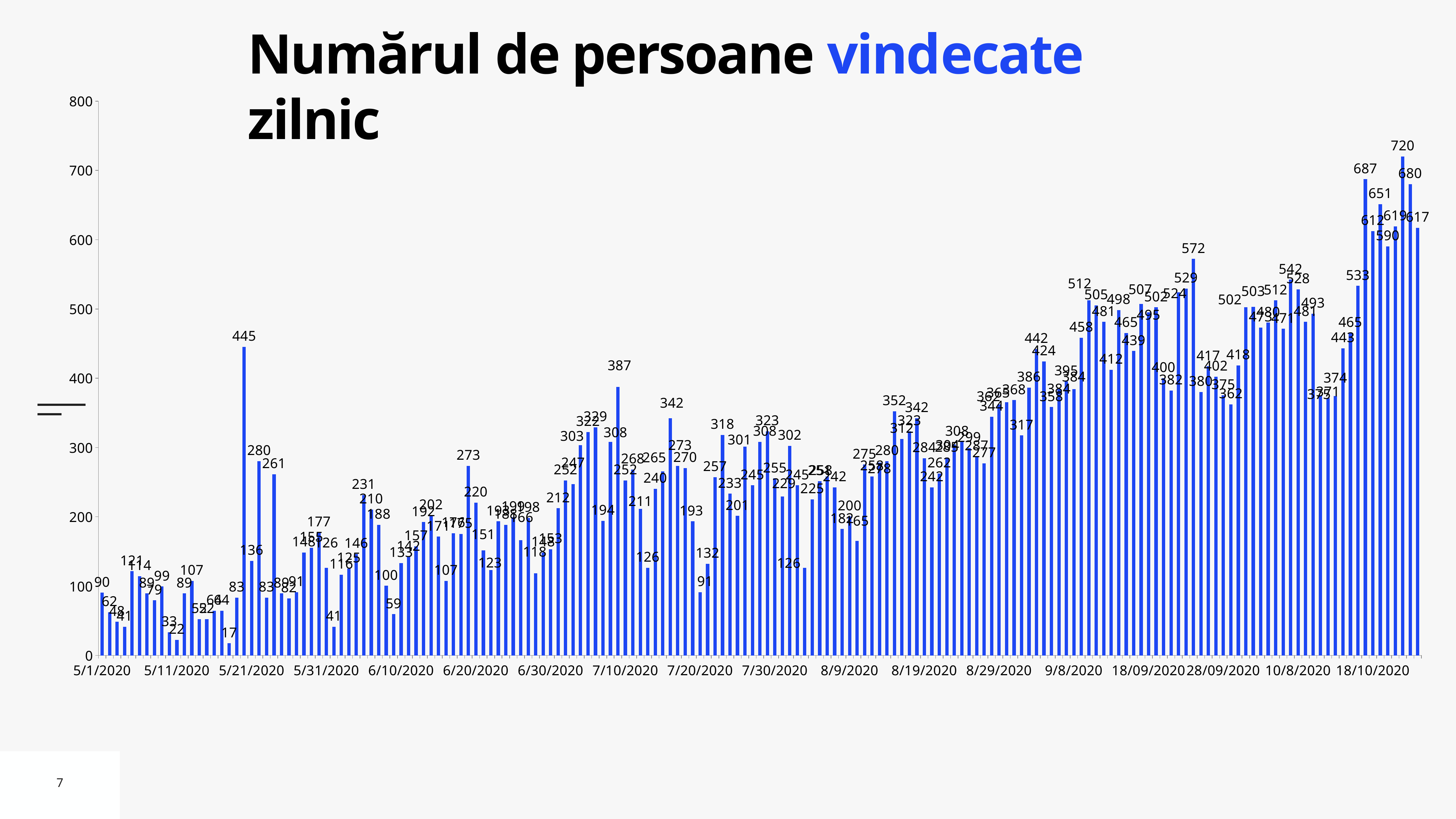
Which is larger, the value for 5/21/2020 or the value for 7/10/2020? 7/10/2020 Is the value for 5/1/2020 greater or less than 100? less What is the title of the chart? Numărul de persoane vindecate zilnic What is the value for 5/1/2020, the first bar in the chart? 90 What is the highest daily value shown in the chart? 720 What is the value of the last bar in the chart? 617 What is the value for 5/21/2020? 136 What kind of chart is shown on the slide? bar chart What is the difference between the value for 5/21/2020 and the value for 7/10/2020? 116 What is the value for 7/10/2020? 252 What is the lowest daily value shown in the chart? 17 Overall, do the values rise or fall from May 2020 to October 2020? rise